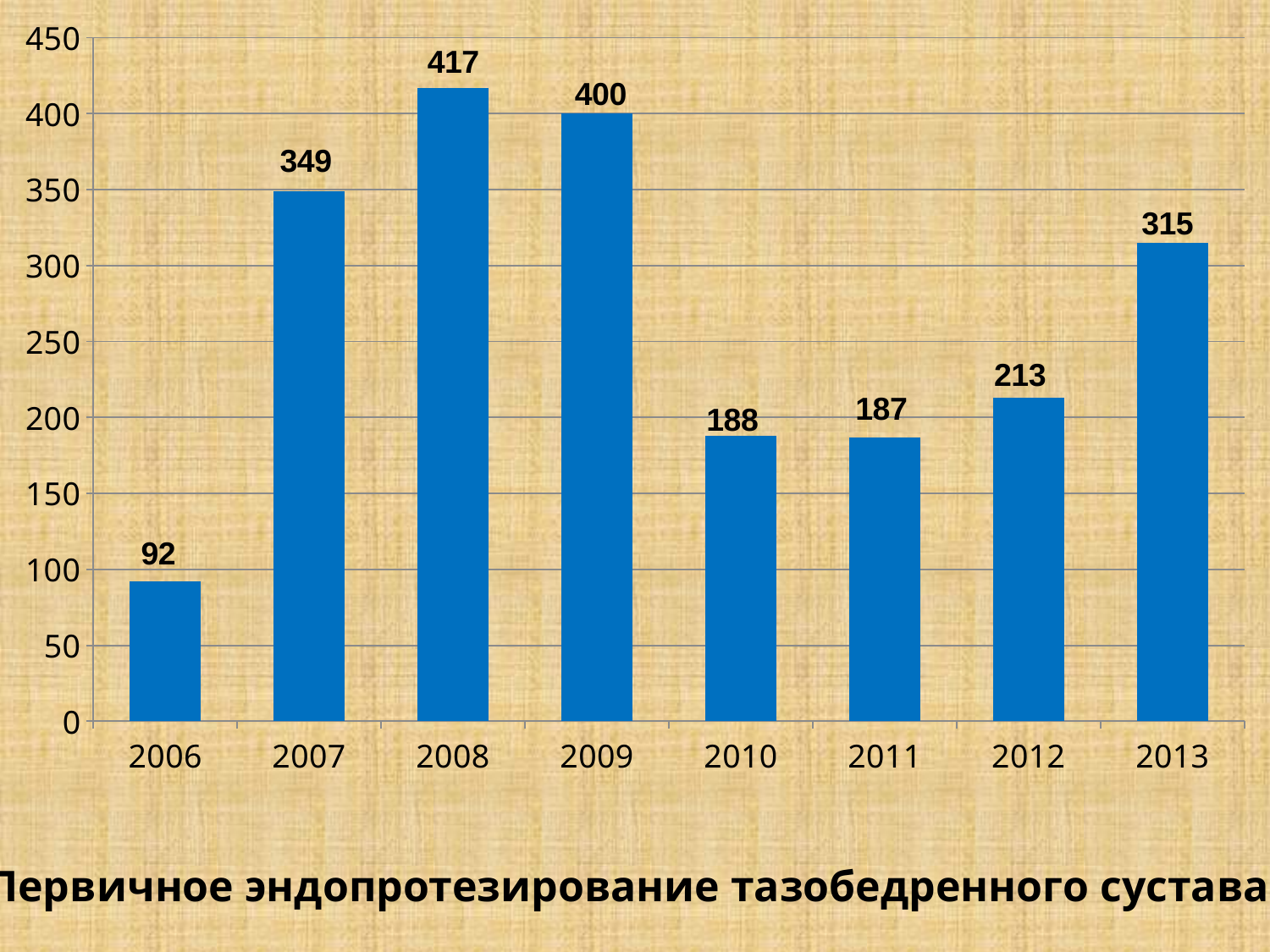
What is the value for 2011? 187 What is the difference between the values for 2013 and 2012? 102 Is the value for 2010 greater or less than 200? less What is the difference between the values for 2008 and 2009? 17 Which year has the lowest value? 2006 Which year has the highest value? 2008 Which is larger, the value for 2007 or the value for 2013? 2007 How many years are shown on the x axis? 8 What kind of chart is shown on the slide? bar chart Do the values rise or fall from 2010 to 2013? rise What is the value for 2008? 417 What is the value for 2013? 315